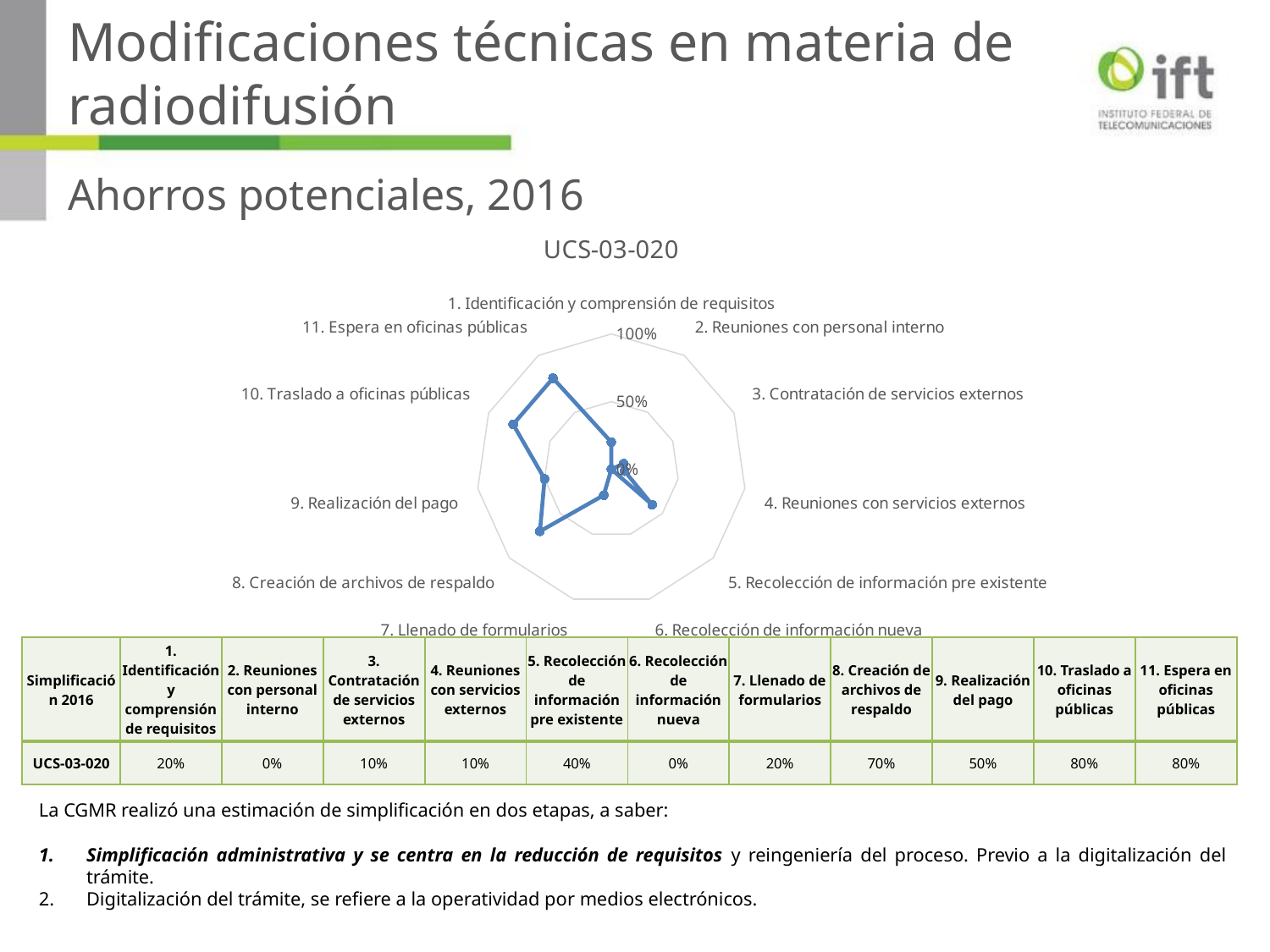
What is the title of the chart? UCS-03-020 What is the value for '8. Creación de archivos de respaldo'? 70% Which has a larger value: '9. Realización del pago' or '5. Recolección de información pre existente'? 9. Realización del pago Is the value for '11. Espera en oficinas públicas' greater or less than 50%? greater What is the difference between the values for '8. Creación de archivos de respaldo' and '9. Realización del pago'? 20 percentage points How many categories (axes) does the radar chart have? 11 What is the lowest value plotted on the chart? 0% What type of chart is shown on the slide? Radar chart What is the value for '2. Reuniones con personal interno'? 0% What is the highest value plotted on the chart? 80% What is the value for '10. Traslado a oficinas públicas'? 80% What is the value for '5. Recolección de información pre existente'? 40%